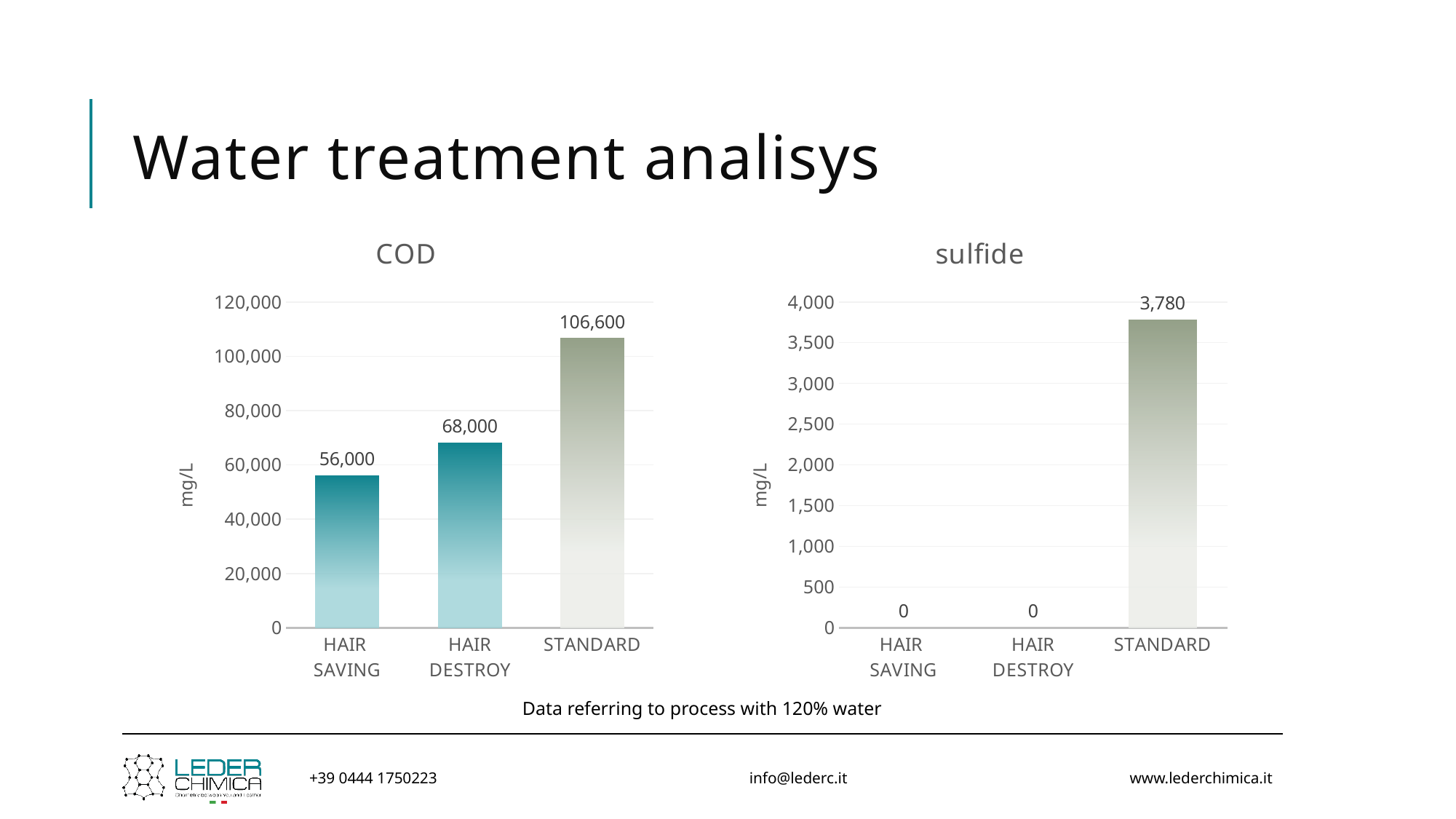
How many categories are shown in the sulfide chart? 3 In the COD chart, what is the value for HAIR SAVING? 56,000 In the COD chart, which is larger, HAIR SAVING or HAIR DESTROY? HAIR DESTROY In the COD chart, which category has the highest value? STANDARD In the COD chart, what is the value for STANDARD? 106,600 What unit is shown on the y axis of the COD chart? mg/L In the sulfide chart, what is the value for HAIR DESTROY? 0 What type of chart is the COD chart? bar chart In the sulfide chart, is the value for STANDARD greater or less than 3,500? greater In the COD chart, which category has the lowest value? HAIR SAVING In the sulfide chart, what is the value for STANDARD? 3,780 In the COD chart, what is the difference between the STANDARD and HAIR DESTROY values? 38,600